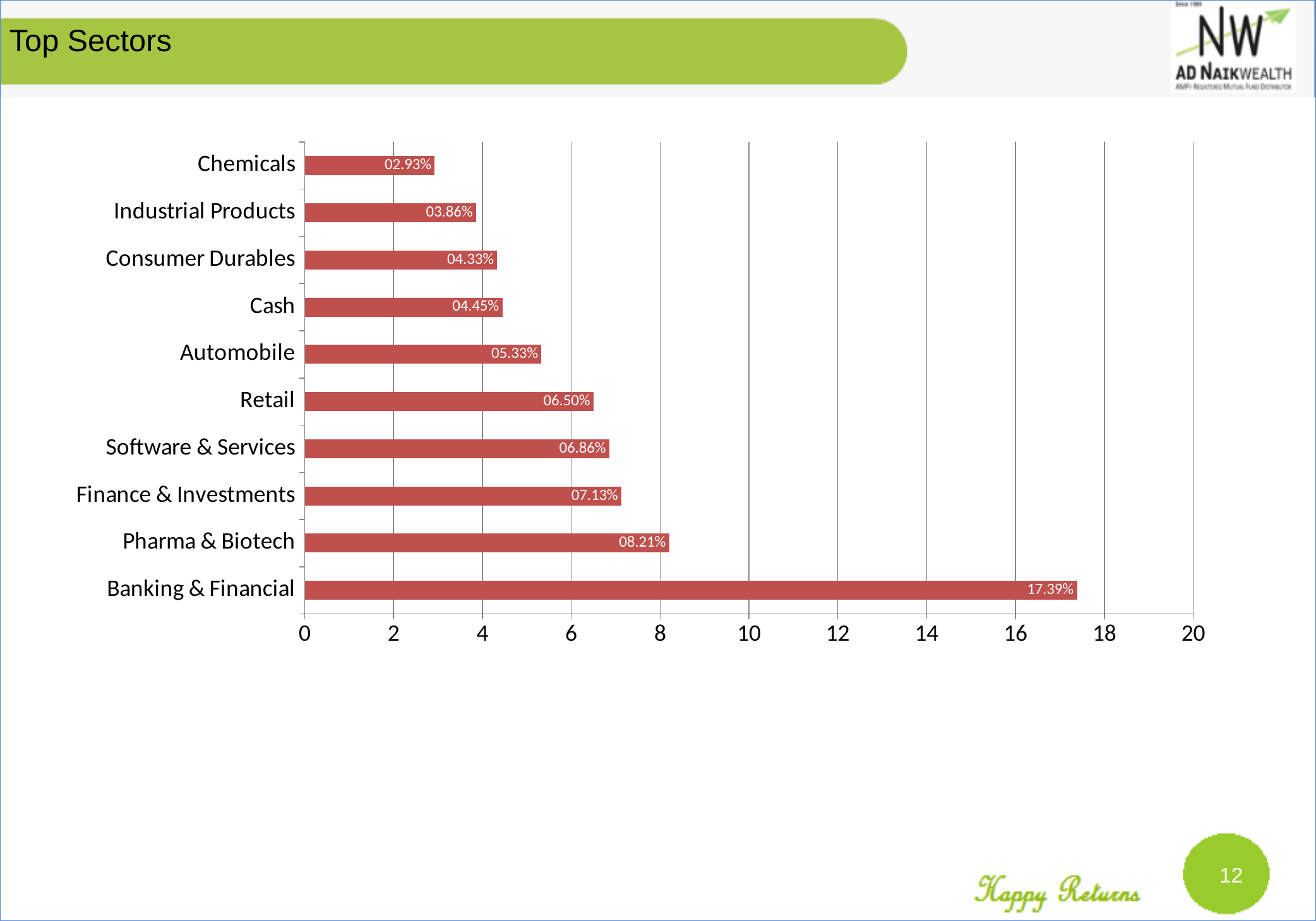
Is the value for Finance & Investments greater or less than 6? greater What is the value for Chemicals? 02.93% How many sectors are shown in the chart? 10 Which sector has the lowest value? Chemicals What kind of chart is shown on the slide? Bar chart What is the value for Cash? 04.45% What is the difference between the values for Banking & Financial and Pharma & Biotech? 9.18% Which is larger, the value for Automobile or the value for Software & Services? Software & Services What is the value for Retail? 06.50% What is the title of the slide? Top Sectors Which sector has the highest value? Banking & Financial What is the value for Banking & Financial? 17.39%